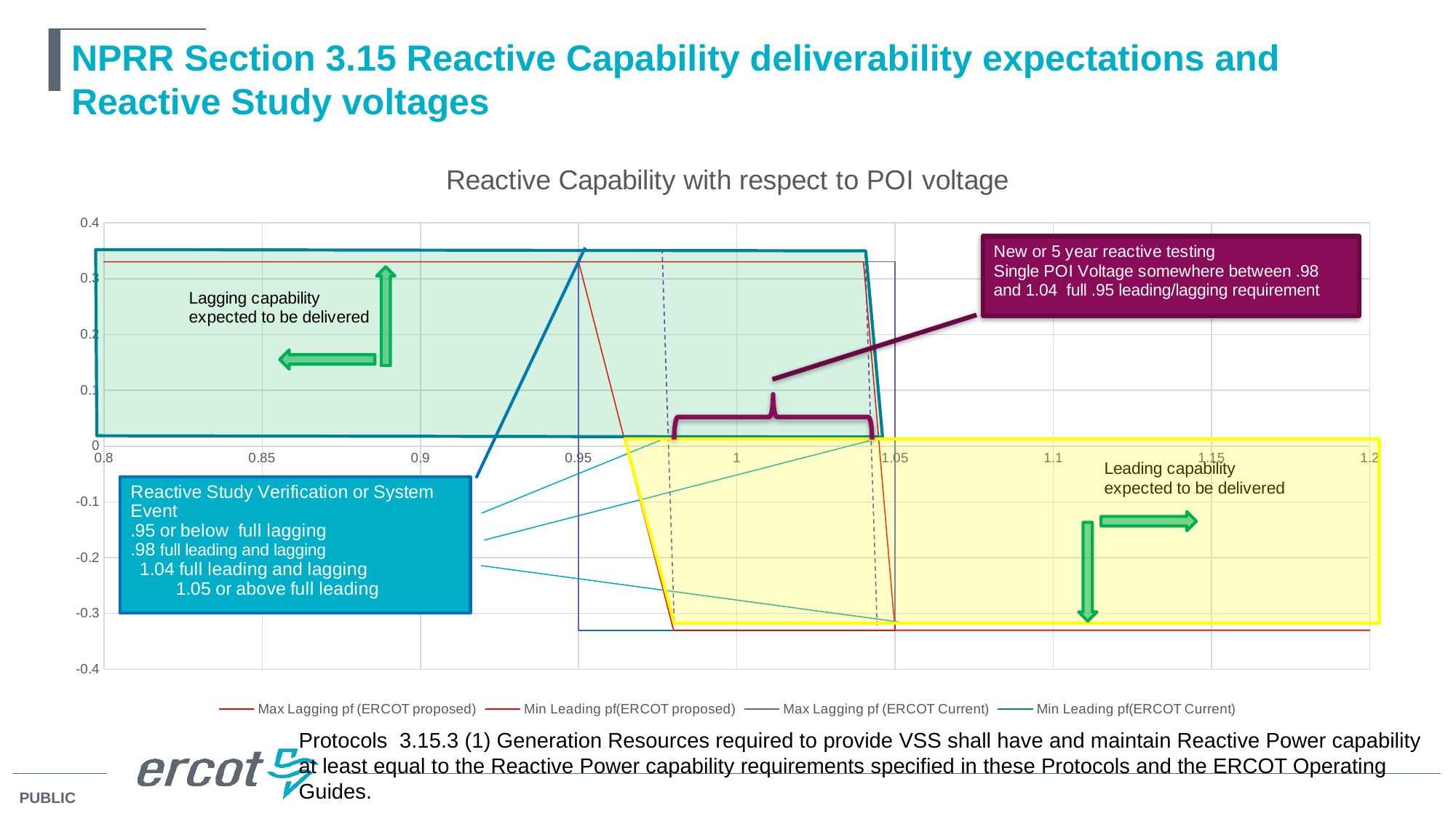
What is the lowest value shown on the chart's x axis? 0.8 Is the value of Max Lagging pf (ERCOT proposed) at a POI voltage of 0.9 greater or less than 0.2? greater What is the title of the chart? Reactive Capability with respect to POI voltage Does the Max Lagging pf (ERCOT proposed) line rise or fall as POI voltage increases from 0.95 to 1.05? fall Is the value of Min Leading pf(ERCOT proposed) at a POI voltage of 1.1 greater or less than -0.2? less Does the Min Leading pf(ERCOT Current) line rise or fall as POI voltage increases from 1.04 to 1.05? rise What type of chart is shown on the slide? Line chart What is the highest value shown on the chart's y axis? 0.4 How many tick labels are shown on the chart's x axis? 9 How many series does the chart legend list? 4